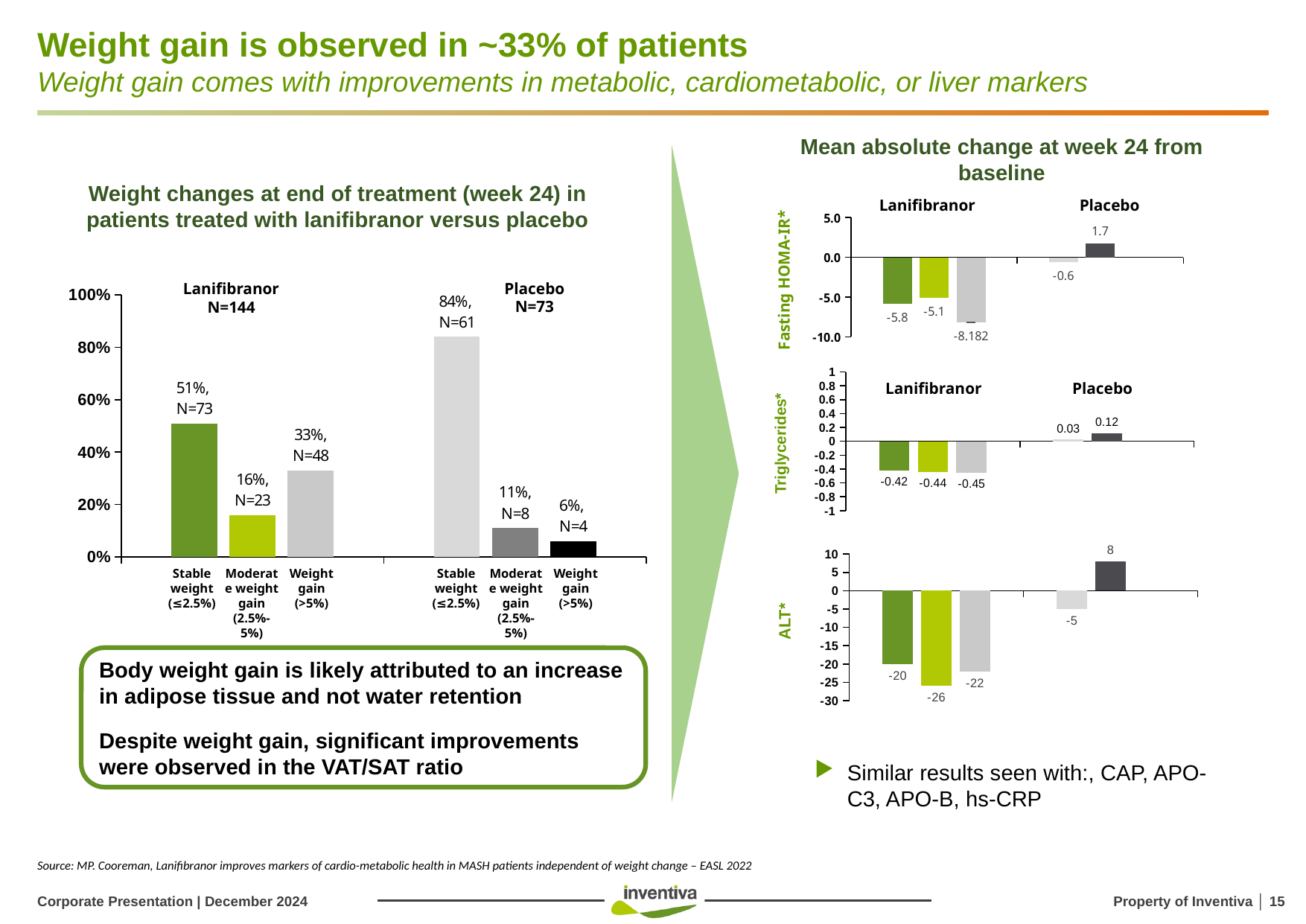
In the Triglycerides chart on the right, what is the highest value shown for the placebo group? 0.12 What type of chart is the 'Weight changes at end of treatment (week 24)' chart? Bar chart In the 'Weight changes at end of treatment (week 24)' chart, how many lanifibranor patients had moderate weight gain (2.5%-5%)? N=23 In the 'Weight changes at end of treatment (week 24)' chart, which is larger: the stable weight percentage for lanifibranor or for placebo? Placebo In the 'Weight changes at end of treatment (week 24)' chart, how many bars are plotted in total? 6 In the 'Weight changes at end of treatment (week 24)' chart, which category has the highest percentage across both groups? Stable weight (≤2.5%) in the placebo group In the Fasting HOMA-IR chart on the right, what is the lowest value shown for the lanifibranor group? -8.182 In the 'Weight changes at end of treatment (week 24)' chart, what percentage of placebo patients had weight gain (>5%)? 6% In the 'Weight changes at end of treatment (week 24)' chart, what is the difference in percentage points between lanifibranor and placebo patients with weight gain (>5%)? 27 percentage points In the 'Weight changes at end of treatment (week 24)' chart, what percentage of lanifibranor patients had stable weight (≤2.5%)? 51% In the ALT chart on the right, what is the lowest value shown for the lanifibranor group? -26 In the Fasting HOMA-IR chart on the right, what is the highest value shown for the placebo group? 1.7